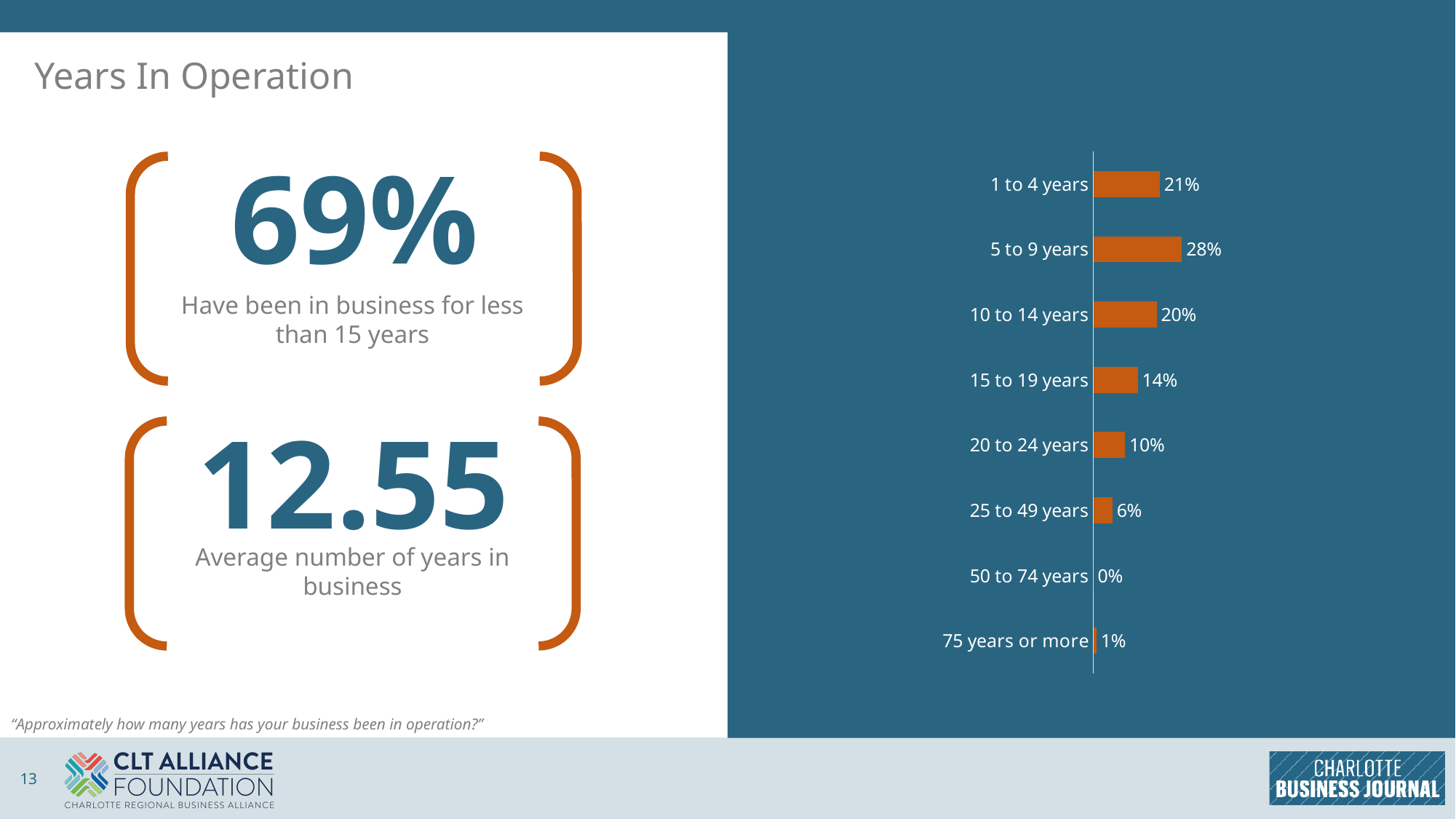
What kind of chart is shown on the slide? Bar chart What percentage of businesses have been in operation for 5 to 9 years? 28% What is the value shown for the 15 to 19 years category? 14% Which category has the highest percentage? 5 to 9 years How many categories are shown in the chart? 8 What is the difference between the 5 to 9 years and 25 to 49 years values? 22% Which is larger, the value for 20 to 24 years or the value for 25 to 49 years? 20 to 24 years What percentage is shown for 75 years or more? 1% What colour are the bars in the chart? Orange What is the difference between the percentages for 1 to 4 years and 10 to 14 years? 1% What is the combined percentage for the 1 to 4 years, 5 to 9 years and 10 to 14 years categories? 69% Which category has the lowest percentage? 50 to 74 years